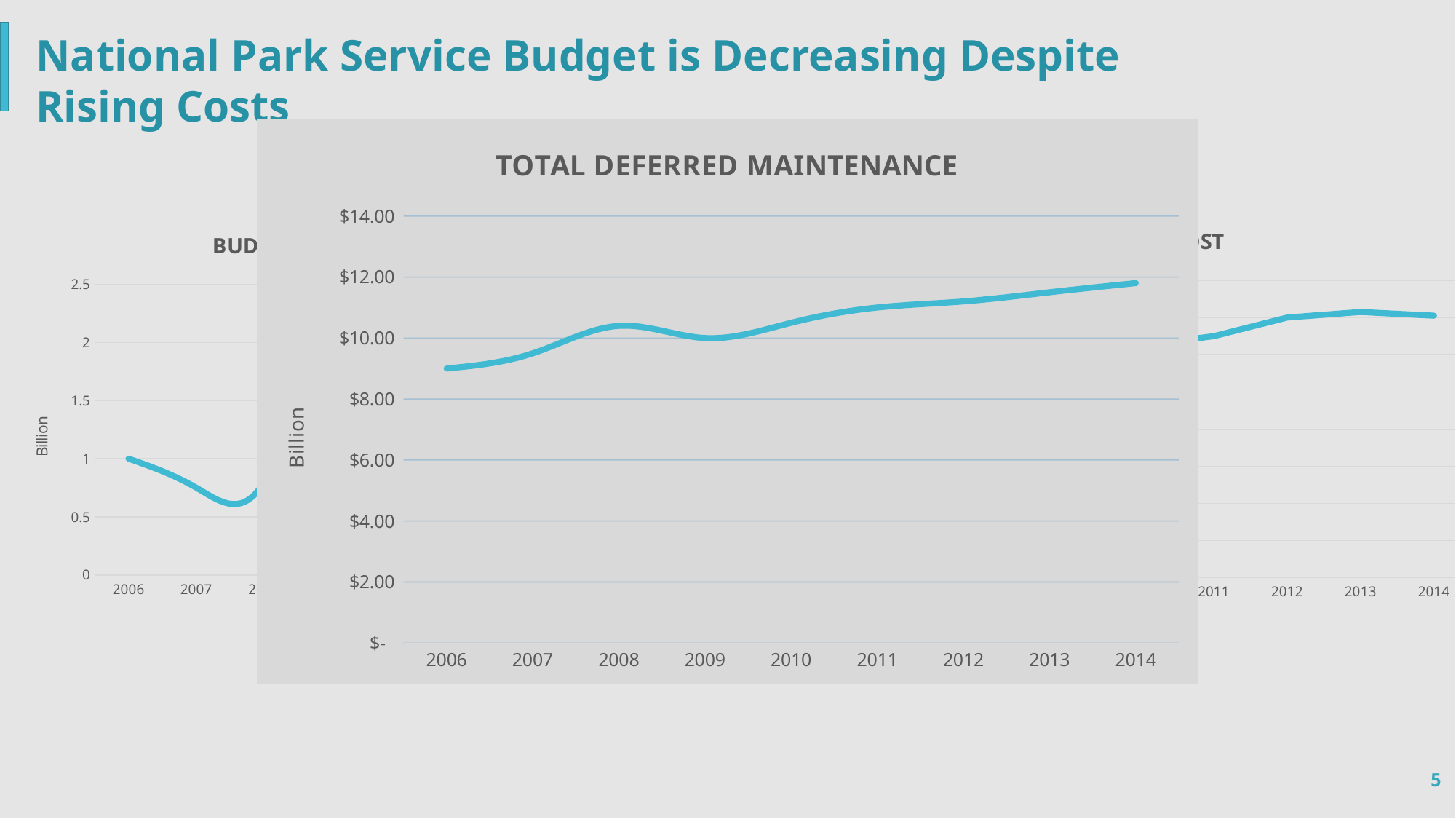
What is the title of the chart in the centre of the slide? TOTAL DEFERRED MAINTENANCE In the TOTAL DEFERRED MAINTENANCE chart, do the values generally rise or fall from 2006 to 2014? rise In the TOTAL DEFERRED MAINTENANCE chart, which year has the highest value? 2014 In the TOTAL DEFERRED MAINTENANCE chart, is the value for 2014 greater or less than $12.00? less What is the y-axis label of the TOTAL DEFERRED MAINTENANCE chart? Billion In the TOTAL DEFERRED MAINTENANCE chart, which year has the larger value, 2006 or 2014? 2014 What kind of chart is the TOTAL DEFERRED MAINTENANCE chart? line chart In the TOTAL DEFERRED MAINTENANCE chart, which year has the lowest value? 2006 In the TOTAL DEFERRED MAINTENANCE chart, how many years are shown on the x axis? 9 In the TOTAL DEFERRED MAINTENANCE chart, is the value for 2006 greater or less than $10.00? less In the TOTAL DEFERRED MAINTENANCE chart, is the value for 2014 greater or less than $10.00? greater